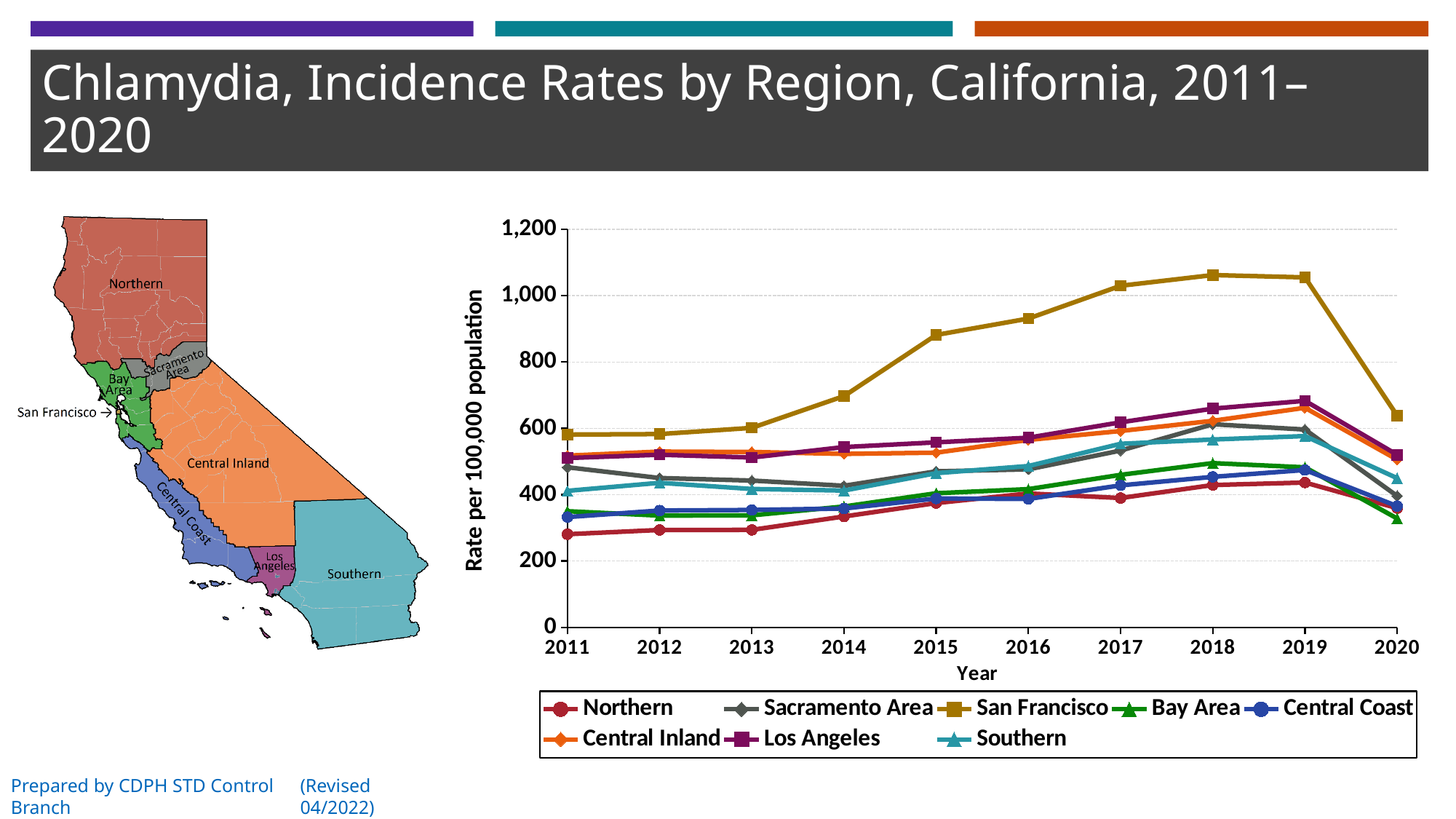
Which is larger in 2015, the rate for San Francisco or the rate for Northern? San Francisco How many years are plotted along the x axis? 10 Is the value for San Francisco in 2018 greater or less than 1,000? greater What kind of chart is shown on the slide? line chart Which region had the highest chlamydia incidence rate in 2018? San Francisco Which region had the lowest chlamydia incidence rate in 2011? Northern Is the value for San Francisco in 2014 greater or less than 800? less Is the value for Northern in 2011 greater or less than 400? less What is the label on the y axis of the chart? Rate per 100,000 population Did the San Francisco rate rise or fall between 2011 and 2018? rise Did the rates for all regions rise or fall between 2019 and 2020? fall How many series does the legend list? 8